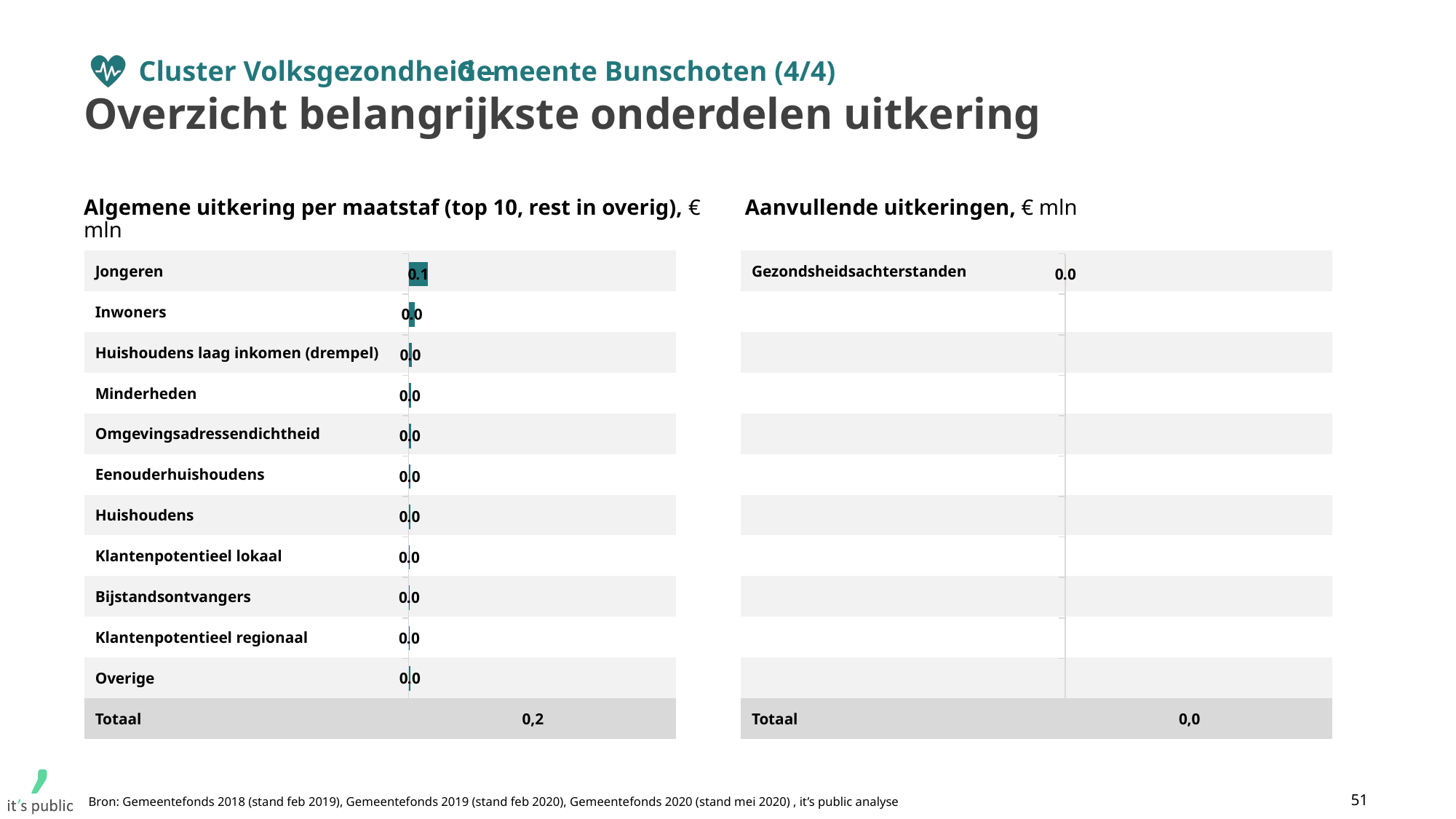
In what unit are the values in the 'Algemene uitkering per maatstaf' chart on the left expressed? € mln In the 'Aanvullende uitkeringen' chart on the right, what is the Totaal value? 0,0 In the 'Algemene uitkering per maatstaf' chart on the left, what is the value for Overige? 0.0 How many categories (excluding the Totaal row) are shown in the 'Aanvullende uitkeringen' chart on the right? 1 In the 'Algemene uitkering per maatstaf' chart on the left, which category has the highest value? Jongeren In the 'Algemene uitkering per maatstaf' chart on the left, what is the value for Jongeren? 0.1 In the 'Aanvullende uitkeringen' chart on the right, what is the value for Gezondsheidsachterstanden? 0.0 In the 'Algemene uitkering per maatstaf' chart on the left, what is the Totaal value? 0,2 What kind of chart is the 'Aanvullende uitkeringen' chart on the right? bar chart How many categories (excluding the Totaal row) are shown in the 'Algemene uitkering per maatstaf' chart on the left? 11 In the 'Algemene uitkering per maatstaf' chart on the left, which is larger: Jongeren or Inwoners? Jongeren What kind of chart is the 'Algemene uitkering per maatstaf' chart on the left? bar chart